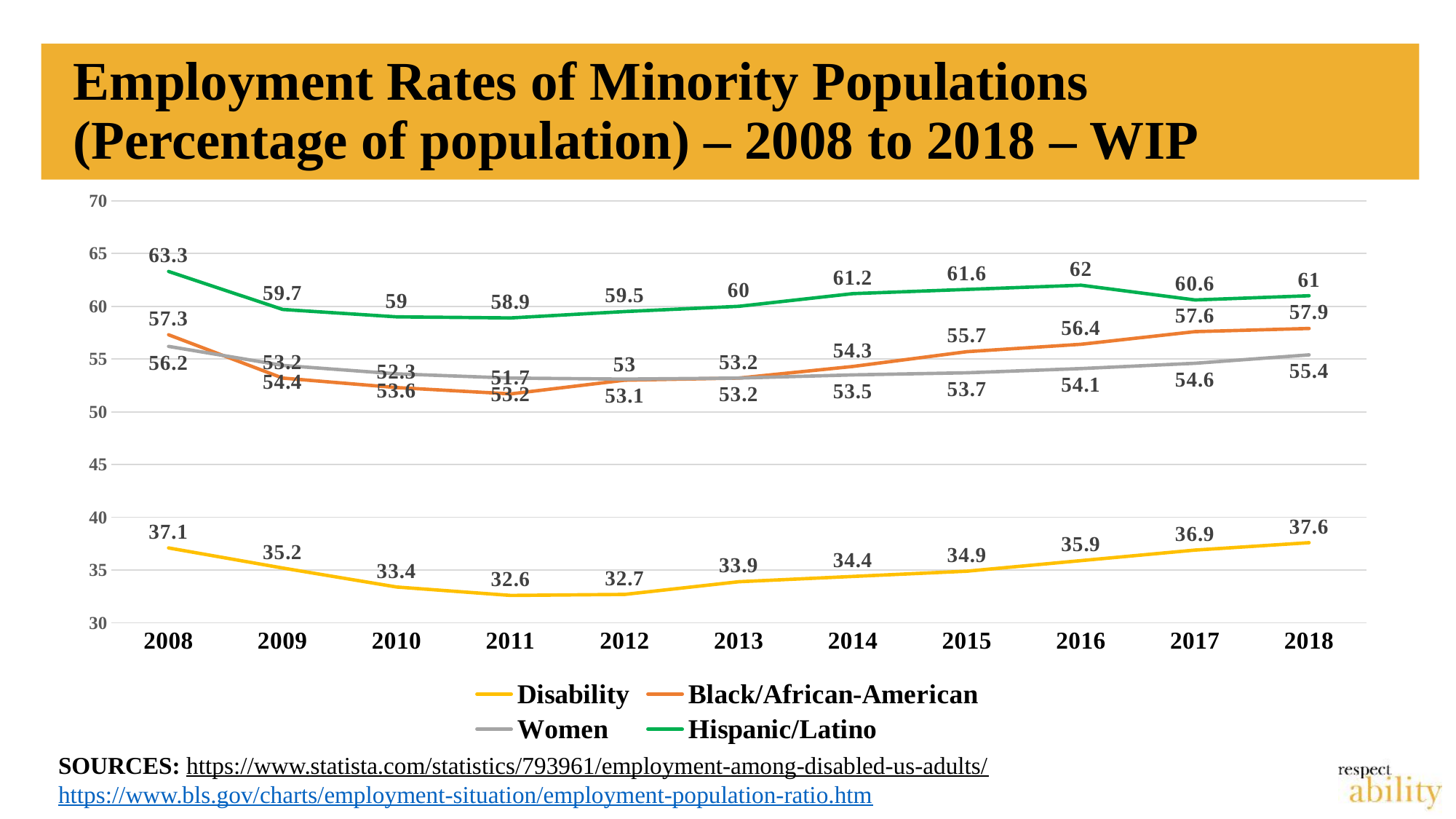
How many series does the legend list? 4 In 2018, which is higher: the Black/African-American rate or the Women rate? Black/African-American How many years are plotted along the x axis? 11 What kind of chart is shown on the slide? Line chart In which year is the Disability employment rate lowest? 2011 Is the Disability employment rate in 2008 greater or less than 35? greater Does the Disability employment rate rise or fall from 2011 to 2018? rise What is the Black/African-American employment rate in 2008? 57.3 What is the Hispanic/Latino employment rate in 2016? 62 What is the Disability employment rate in 2011? 32.6 In which year is the Hispanic/Latino employment rate highest? 2008 By how much does the Disability employment rate in 2018 exceed its 2008 value? 0.5